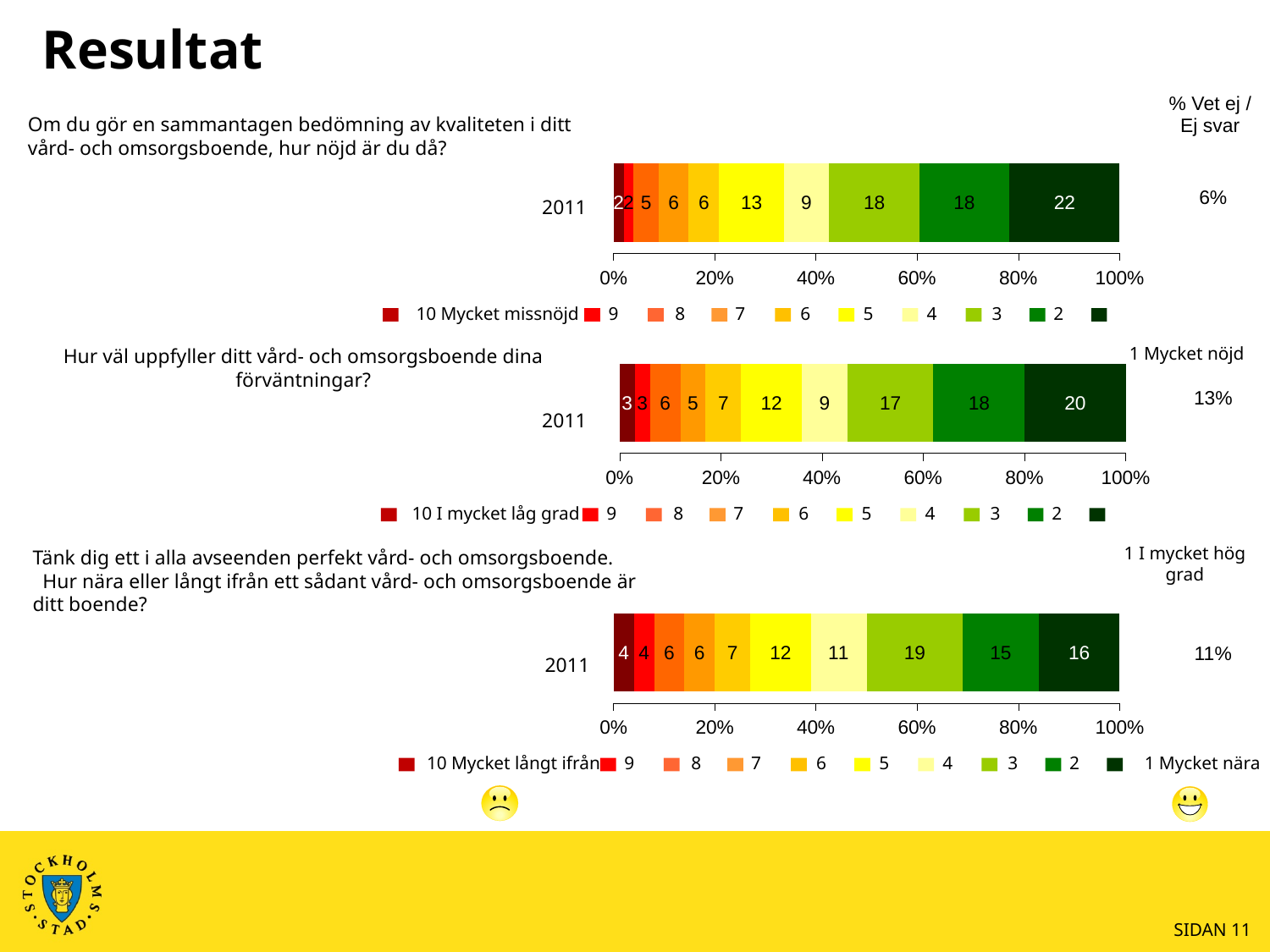
In the middle chart, what is the value of the '3' segment? 17 In the bottom chart, what is the value of the '1 Mycket nära' segment? 16 In the middle chart, what is the difference between the '2' segment and the '5' segment? 6 What kind of chart is the top chart on the slide? stacked bar chart What is the '% Vet ej / Ej svar' value shown next to the middle chart? 13% In the top chart, which segment has the largest value? 1 Mycket nöjd How many series does the legend of the bottom chart list? 10 In the top chart, what is the value of the '1 Mycket nöjd' segment for 2011? 22 In the bottom chart, which segment has the largest value? 3 In the middle chart, what is the value of the '1 I mycket hög grad' segment? 20 In the bottom chart, which is larger, the '2' segment or the '1 Mycket nära' segment? 1 Mycket nära In the top chart, what is the value of the '5' segment for 2011? 13